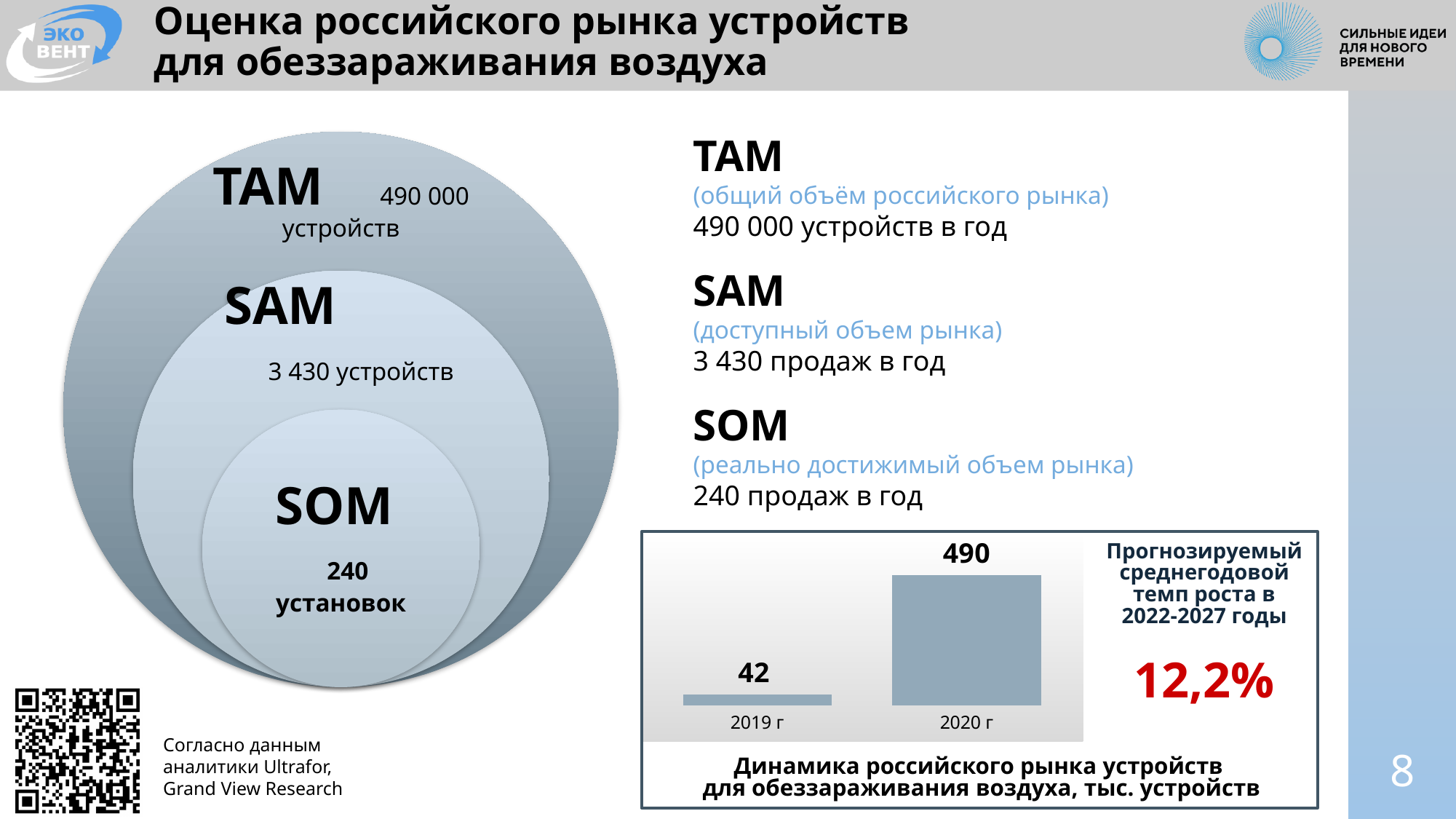
What kind of chart is shown at the bottom right of the slide? bar chart How many bars are shown in the bar chart at the bottom right? 2 In the bar chart at the bottom right, which year has the lowest value? 2019 г In the bar chart at the bottom right, do the values rise or fall from 2019 г to 2020 г? rise In the bar chart 'Динамика российского рынка устройств для обеззараживания воздуха', what is the value for 2020 г? 490 What unit is stated in the title of the bar chart at the bottom right? тыс. устройств In the bar chart at the bottom right, what is the difference between the values for 2020 г and 2019 г? 448 In the bar chart at the bottom right, which year has the highest value? 2020 г In the bar chart 'Динамика российского рынка устройств для обеззараживания воздуха', what is the value for 2019 г? 42 What forecast average annual growth rate for 2022-2027 is shown next to the bar chart? 12,2% In the nested circle diagram on the left, what value is given for SOM? 240 установок In the bar chart at the bottom right, which is larger: the value for 2019 г or for 2020 г? 2020 г